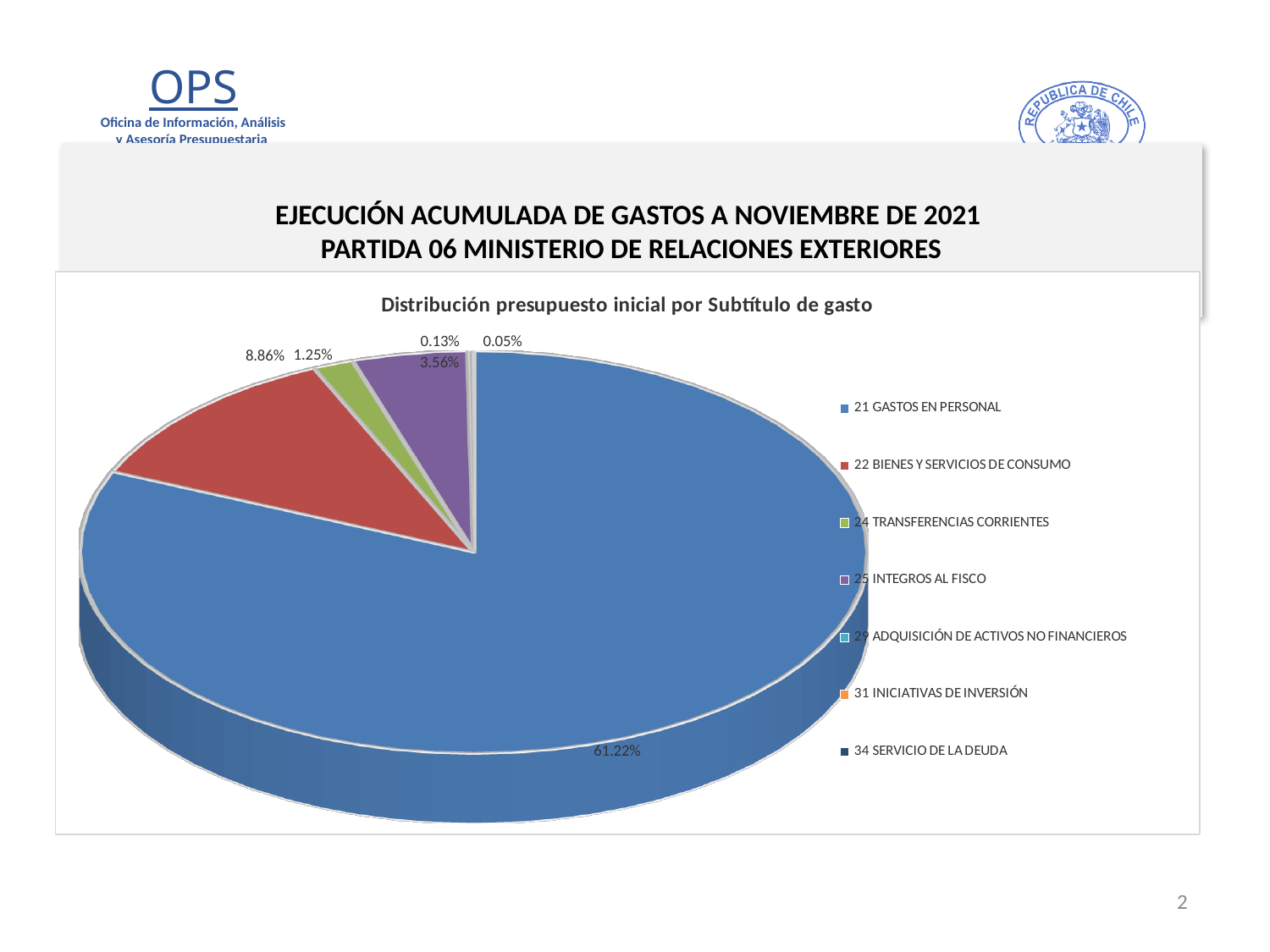
How many entries does the chart legend list? 7 Which subtítulo has the largest share of the pie? 21 GASTOS EN PERSONAL What is the difference in percentage points between 25 INTEGROS AL FISCO and 24 TRANSFERENCIAS CORRIENTES? 2.31% What is the smallest percentage label printed on the chart? 0.05% What percentage is shown for 22 BIENES Y SERVICIOS DE CONSUMO? 8.86% What is the difference in percentage points between 21 GASTOS EN PERSONAL and 22 BIENES Y SERVICIOS DE CONSUMO? 52.36% What percentage is shown for 25 INTEGROS AL FISCO? 3.56% What percentage is shown for 21 GASTOS EN PERSONAL? 61.22% What type of chart is shown on the slide? pie chart Which has a larger share, 22 BIENES Y SERVICIOS DE CONSUMO or 25 INTEGROS AL FISCO? 22 BIENES Y SERVICIOS DE CONSUMO What percentage is shown for 24 TRANSFERENCIAS CORRIENTES? 1.25% What is the title of the chart? Distribución presupuesto inicial por Subtítulo de gasto